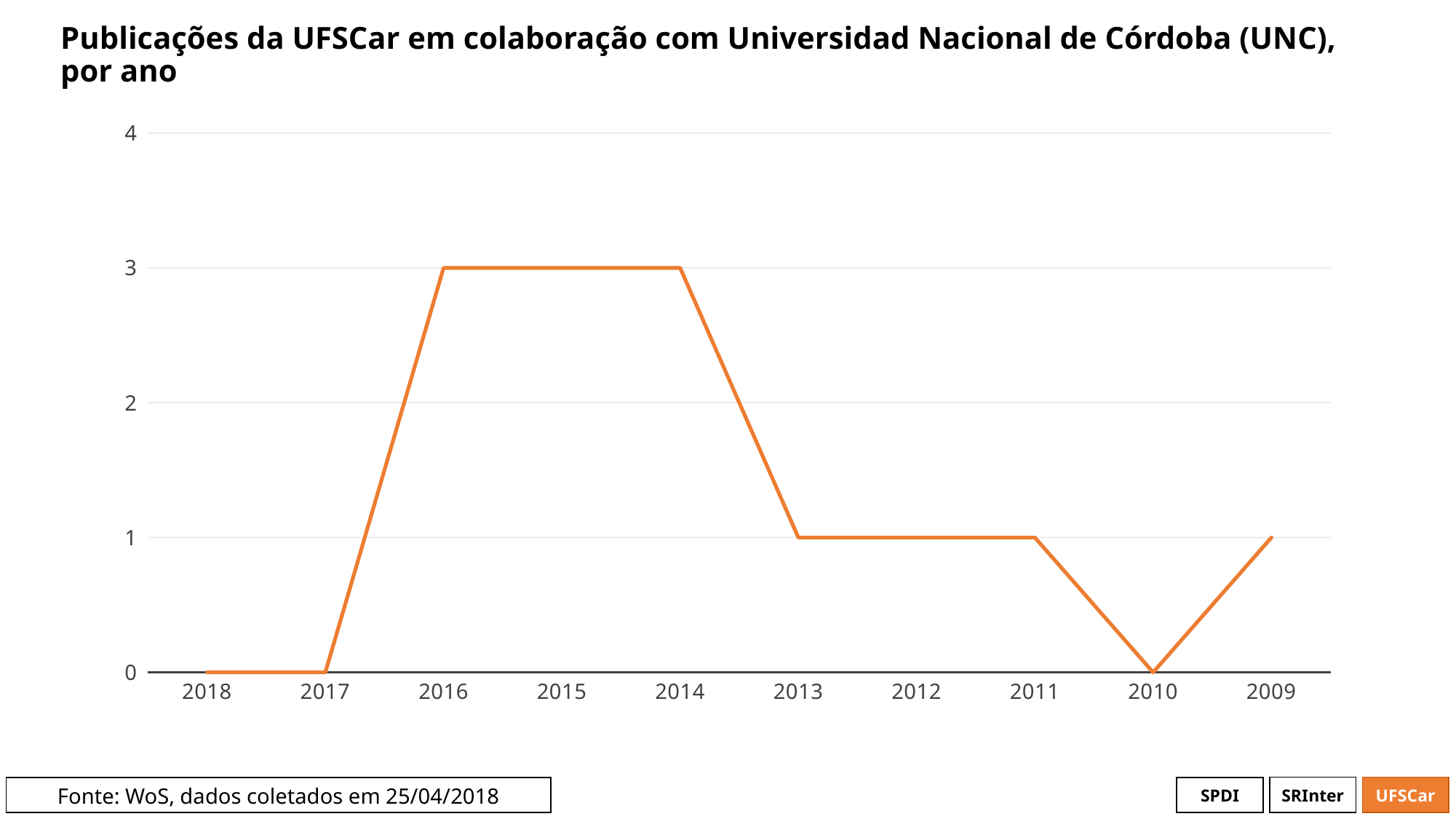
Moving from 2014 to 2013 along the x axis, does the line rise or fall? fall What is the value for 2009? 1 Is the value for 2016 greater or less than 2? greater What is the value for 2013? 1 Which year has the larger value, 2015 or 2012? 2015 What kind of chart is shown on the slide? line chart What is the difference between the values for 2014 and 2013? 2 How many years are shown on the x axis of the chart? 10 What is the value for 2010? 0 What is the title of the chart? Publicações da UFSCar em colaboração com Universidad Nacional de Córdoba (UNC), por ano What is the value for 2016? 3 What is the highest value reached by the line? 3